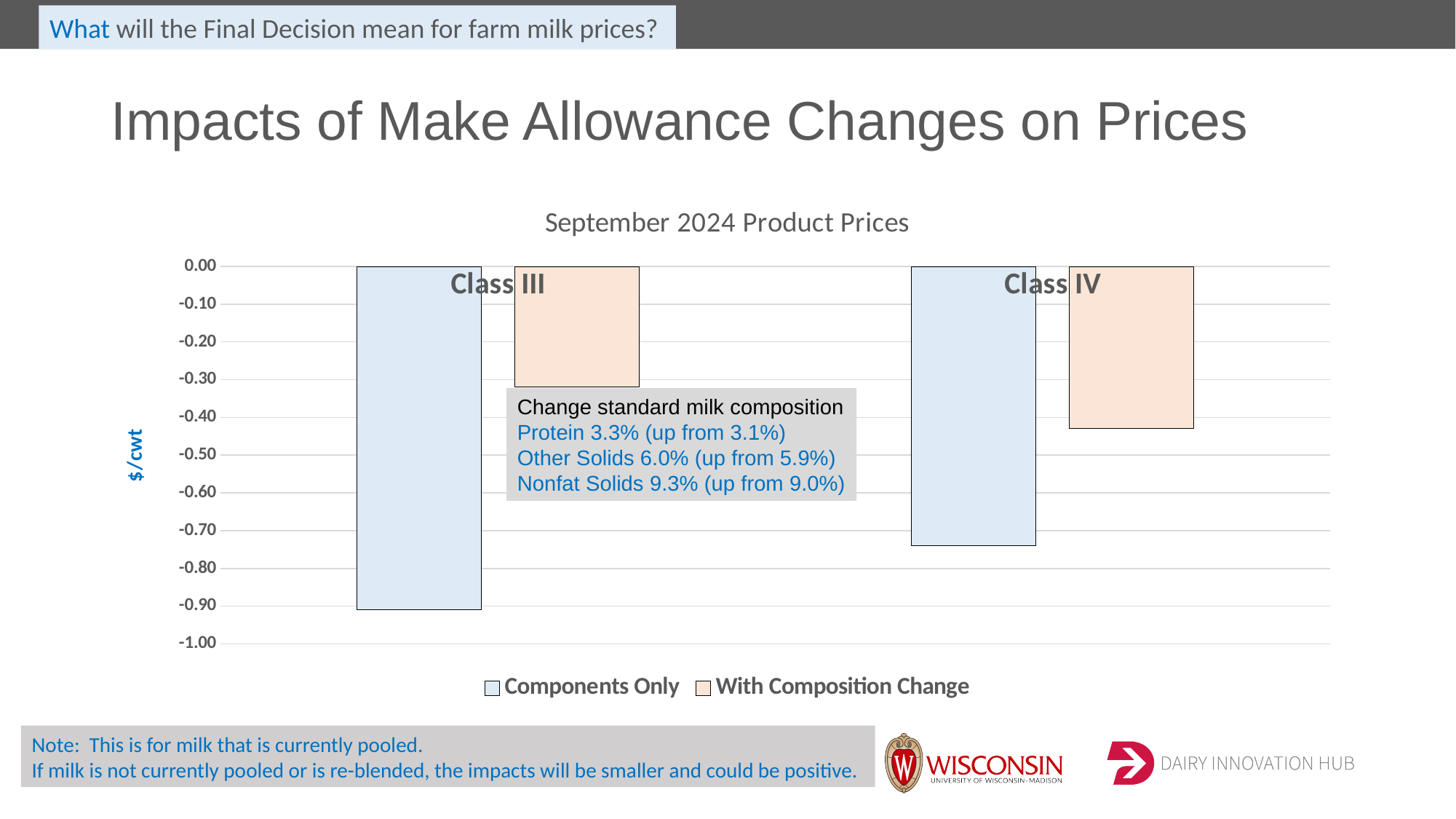
Is the With Composition Change value for Class III greater or less than -0.20? less How many series does the chart legend list? 2 Is the Components Only value for Class III greater or less than -0.80? less What kind of chart is shown on the slide? bar chart What is the title of the chart? September 2024 Product Prices Is the Components Only value for Class IV greater or less than -0.80? greater For the Components Only series, which class has the larger (less negative) value, Class III or Class IV? Class IV Which bar shows the largest price decrease (the lowest value) on the chart? Class III, Components Only What unit is shown on the chart's vertical axis? $/cwt How many milk classes (categories) are shown on the chart? 2